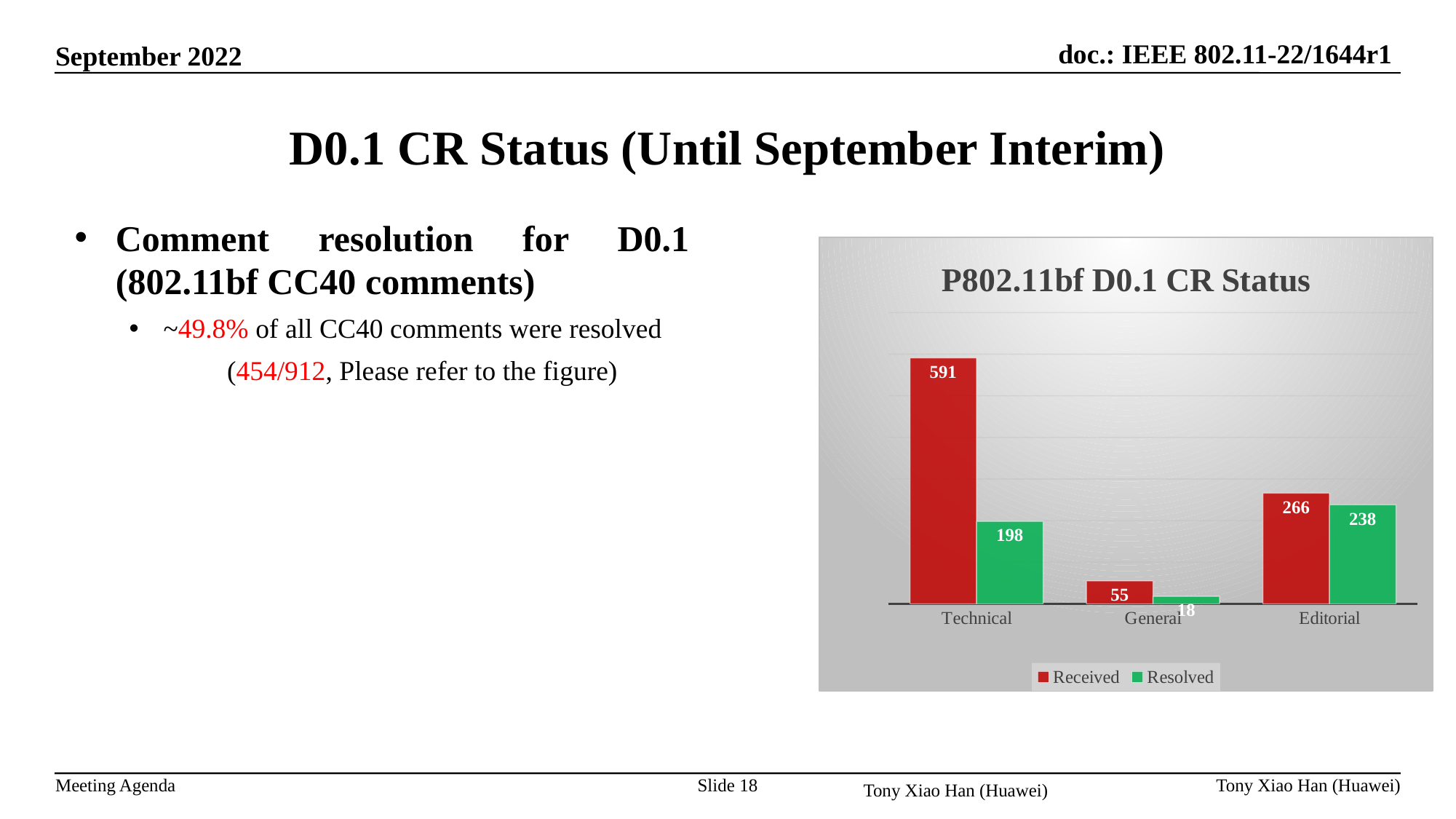
What is the Received value for Technical? 591 Which is larger, the Resolved value for Technical or the Resolved value for Editorial? Editorial Which category has the lowest Resolved value? General What is the Resolved value for Editorial? 238 What is the difference between Received and Resolved for Editorial? 28 What is the Resolved value for General? 18 How many categories are shown on the x axis? 3 What is the difference between Received and Resolved for Technical? 393 Which category has the highest Received value? Technical How many series does the legend list? 2 What is the Received value for Editorial? 266 What kind of chart is shown on the slide? Bar chart